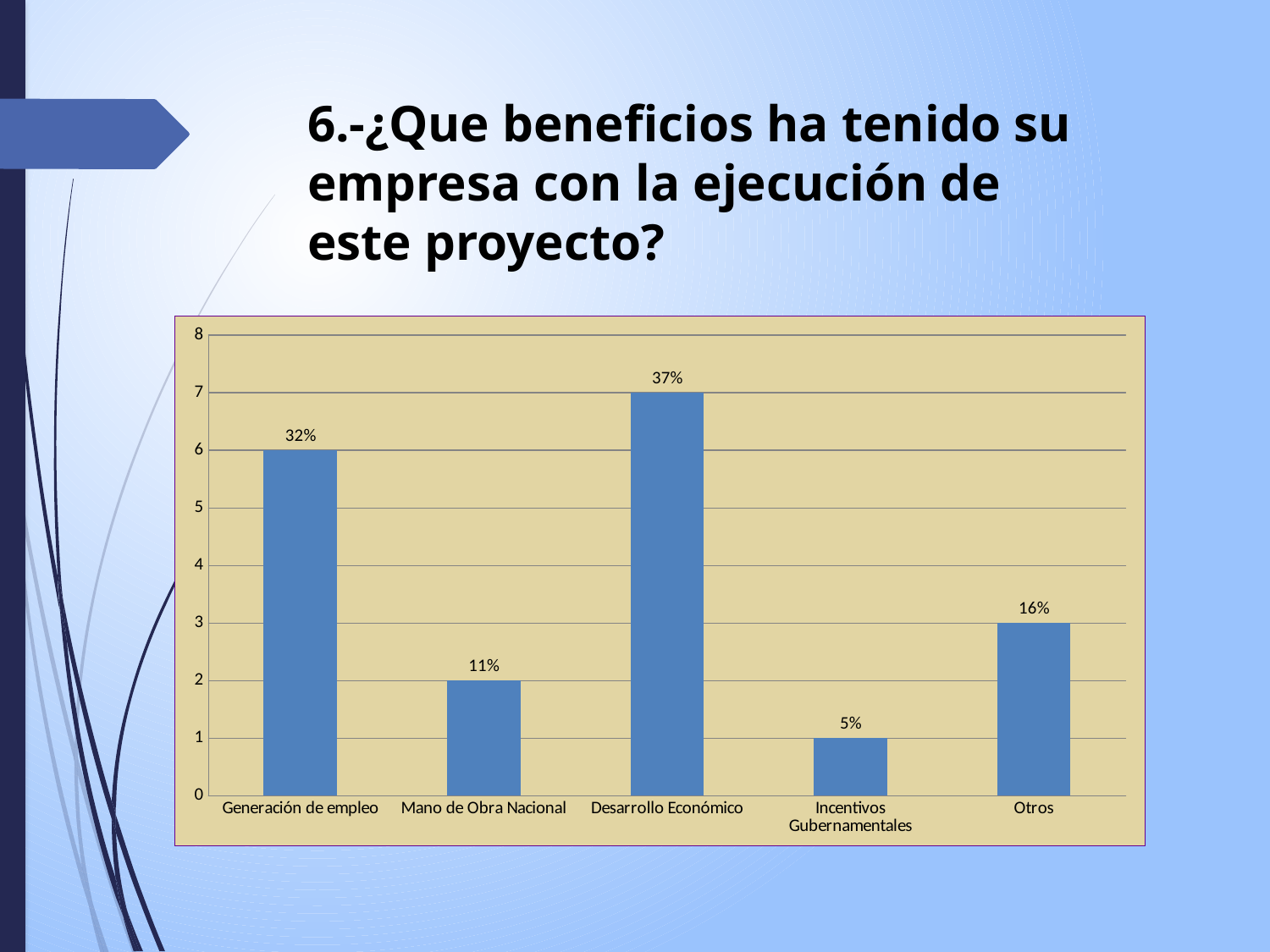
What is the highest value shown on the vertical axis? 8 What is the difference in percentage points between the labels for Desarrollo Económico and Generación de empleo? 5% Which category has the highest bar? Desarrollo Económico What percentage label is shown above the bar for Desarrollo Económico? 37% What kind of chart is shown on the slide? Bar chart What percentage label is shown above the bar for Generación de empleo? 32% Which is larger, the bar for Otros or the bar for Mano de Obra Nacional? Otros On the vertical axis, what value does the bar for Mano de Obra Nacional reach? 2 Which category has the lowest bar? Incentivos Gubernamentales What percentage label is shown above the bar for Incentivos Gubernamentales? 5% On the vertical axis, what value does the bar for Otros reach? 3 How many categories are shown on the horizontal axis? 5